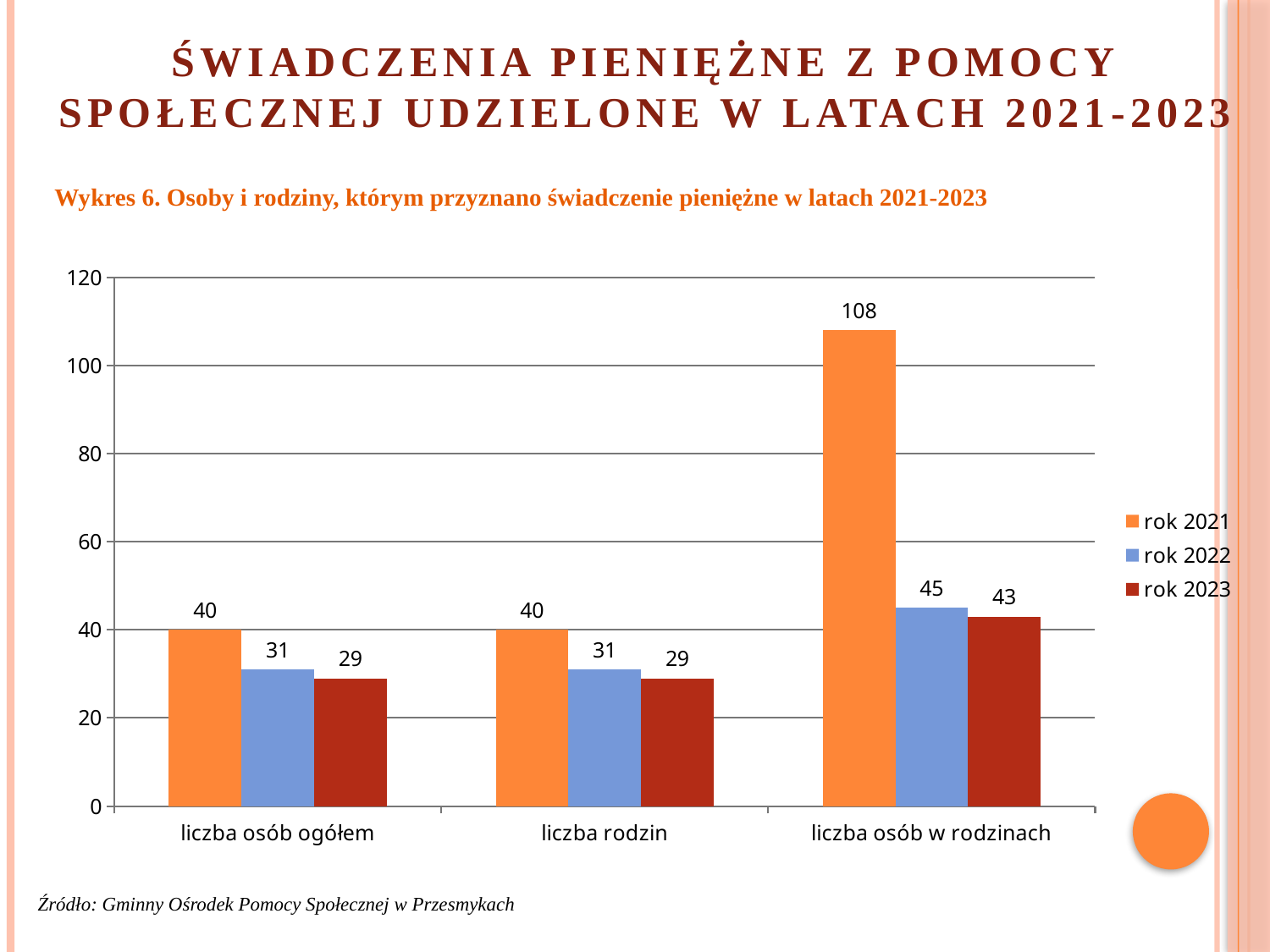
Which is larger: the 'rok 2022' value or the 'rok 2023' value for 'liczba osób w rodzinach'? rok 2022 What colour represents the 'rok 2023' series? dark red What is the value for 'rok 2022' in the 'liczba osób ogółem' category? 31 Which category has the highest value for 'rok 2022'? liczba osób w rodzinach Is the value for 'rok 2021' in 'liczba osób w rodzinach' greater or less than 100? greater What is the value for 'rok 2023' in the 'liczba rodzin' category? 29 How many series does the legend list? 3 What is the difference between the 'rok 2021' and 'rok 2023' values in the 'liczba osób w rodzinach' category? 65 How many categories are shown on the x axis? 3 Which series has the lowest value in the 'liczba osób w rodzinach' category? rok 2023 What is the value for 'rok 2021' in the 'liczba osób w rodzinach' category? 108 What kind of chart is shown on the slide? bar chart